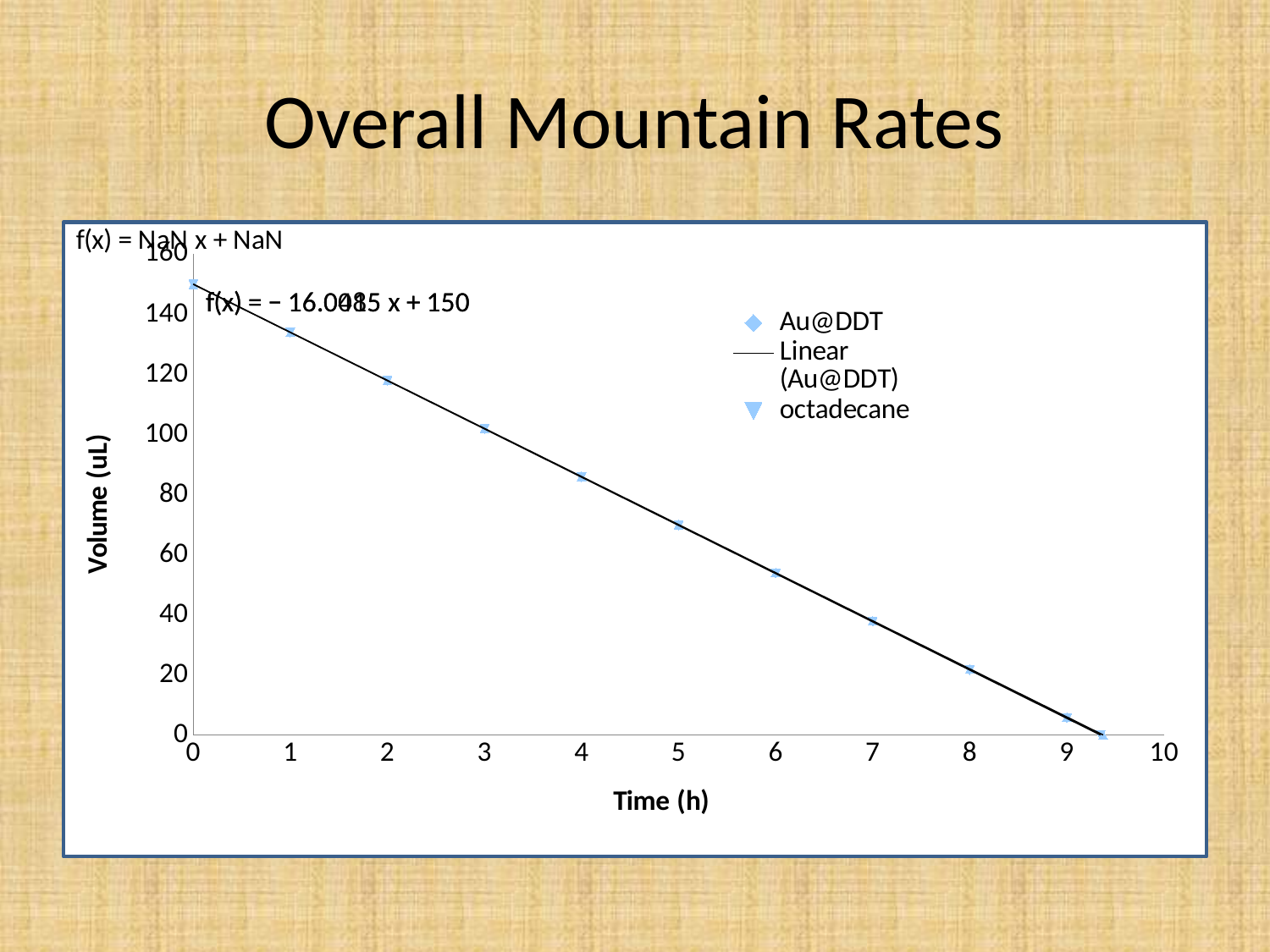
Which has the larger volume, the point at time 3 h or the point at time 6 h? time 3 h Is the volume at time 5 h greater or less than 60? greater Is the volume at time 8 h greater or less than 40? less What kind of chart is shown on the slide? scatter chart with a linear trendline How many entries does the chart legend list? 3 What is the label of the x axis? Time (h) Is the volume at time 0 h greater or less than 140? greater At which time (h) is the plotted volume highest? 0 Do the plotted volume values rise or fall as time increases? fall What is the label of the y axis? Volume (uL)